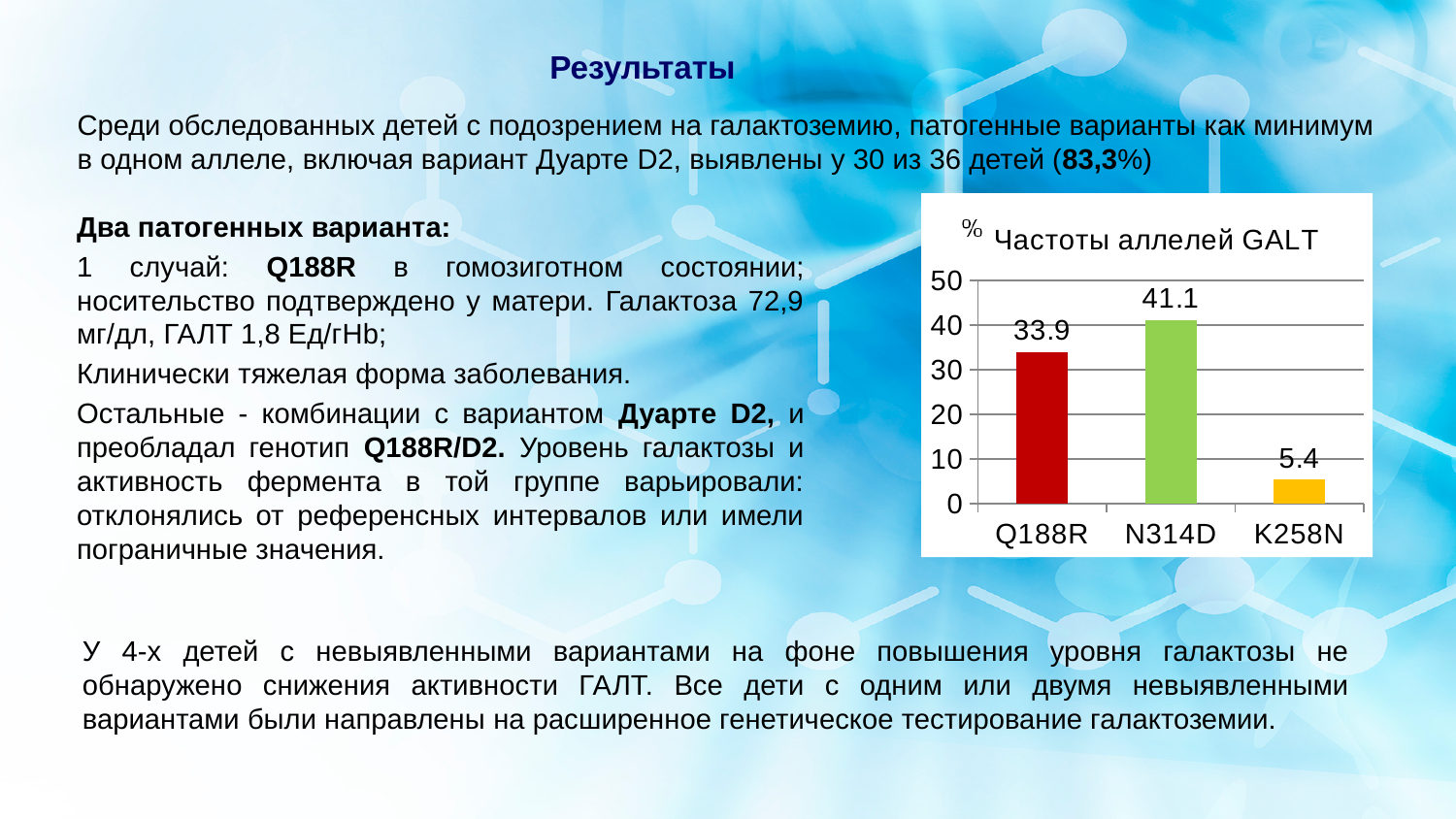
What is the difference between the values for N314D and Q188R? 7.2 Is the value for Q188R greater or less than 40? less What is the value for N314D in the chart? 41.1 What is the title of the chart on the slide? Частоты аллелей GALT What is the value for K258N in the chart? 5.4 What is the value for Q188R in the chart 'Частоты аллелей GALT'? 33.9 Which is larger, the value for Q188R or the value for N314D? N314D Which category has the highest value in the chart? N314D How many categories are shown in the chart? 3 What kind of chart is shown on the slide? bar chart Which category has the lowest value in the chart? K258N What is the difference between the values for Q188R and K258N? 28.5